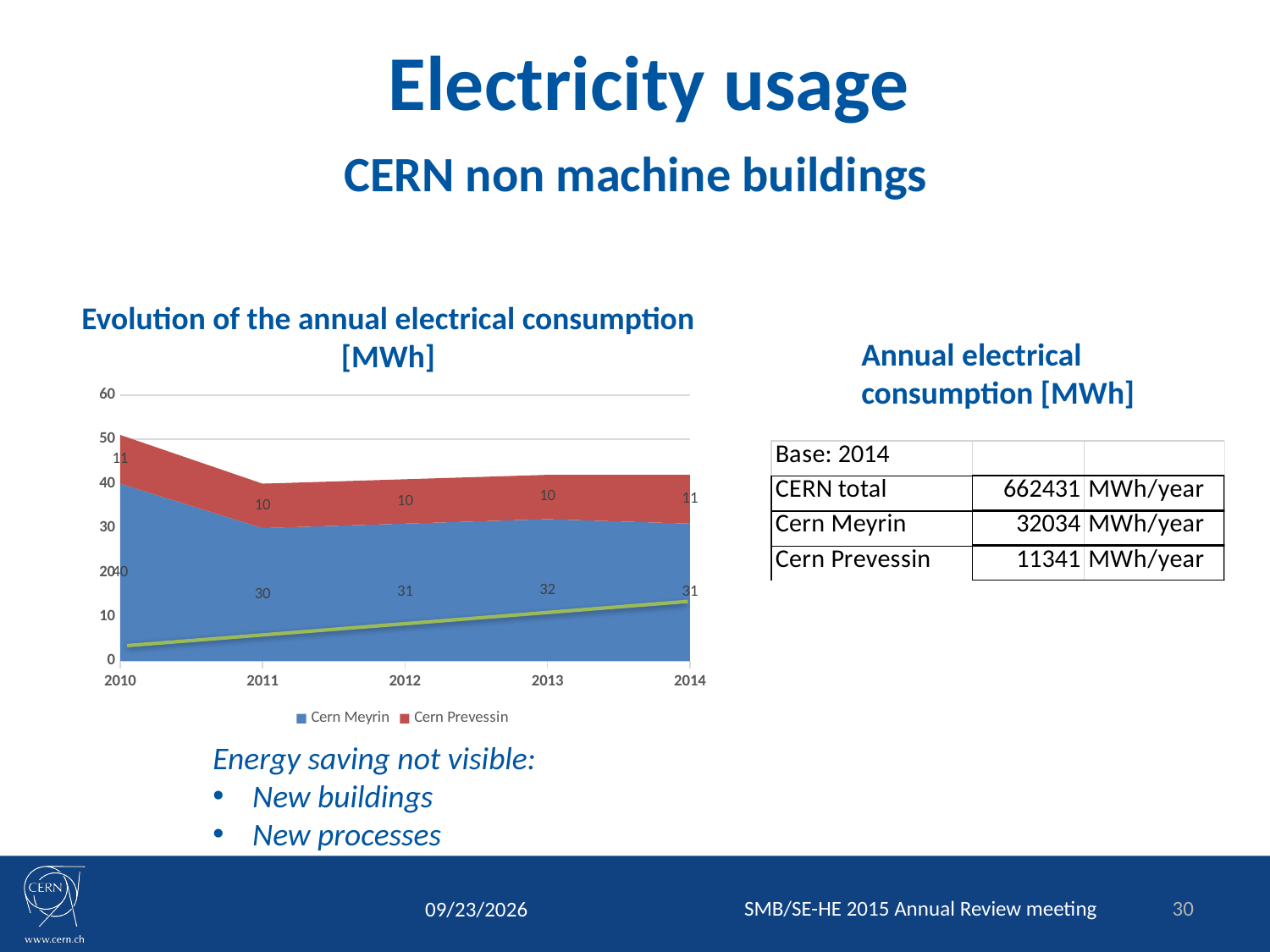
What is the combined total of Cern Meyrin and Cern Prevessin in 2010? 51 In which year is the Cern Meyrin value lowest? 2011 Which is larger, the Cern Meyrin value in 2012 or in 2013? 2013 What is the value for Cern Meyrin in 2013? 32 What kind of chart is shown on the slide? Area chart What is the value for Cern Prevessin in 2012? 10 What is the difference between the Cern Meyrin values in 2010 and 2011? 10 What is the value for Cern Meyrin in 2011? 30 How many years are shown on the x axis of the chart? 5 What is the value for Cern Prevessin in 2014? 11 How many series does the chart legend list? 2 In which year is the Cern Meyrin value highest? 2010